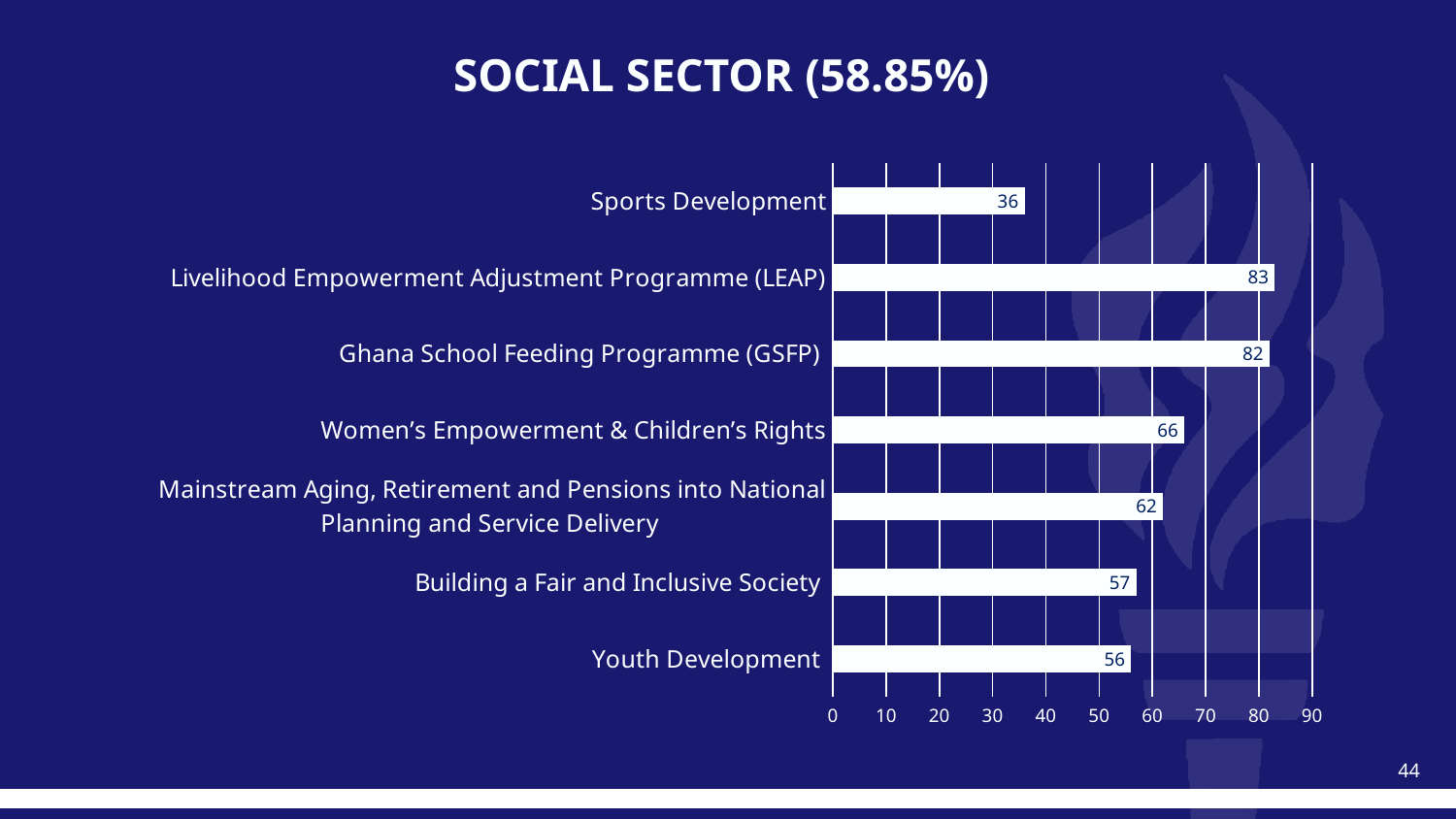
What is the value for Ghana School Feeding Programme (GSFP)? 82 Is the value for Women's Empowerment & Children's Rights greater or less than 60? greater What is the title of the slide? SOCIAL SECTOR (58.85%) What kind of chart is shown on the slide? Bar chart What is the value for Sports Development? 36 What is the value for Youth Development? 56 What is the maximum value shown on the x axis? 90 What is the difference between the values for Women's Empowerment & Children's Rights and Building a Fair and Inclusive Society? 9 Which category has the highest value? Livelihood Empowerment Adjustment Programme (LEAP) Which is larger: the value for Mainstream Aging, Retirement and Pensions into National Planning and Service Delivery or the value for Youth Development? Mainstream Aging, Retirement and Pensions into National Planning and Service Delivery How many categories are shown in the chart? 7 Which category has the lowest value? Sports Development